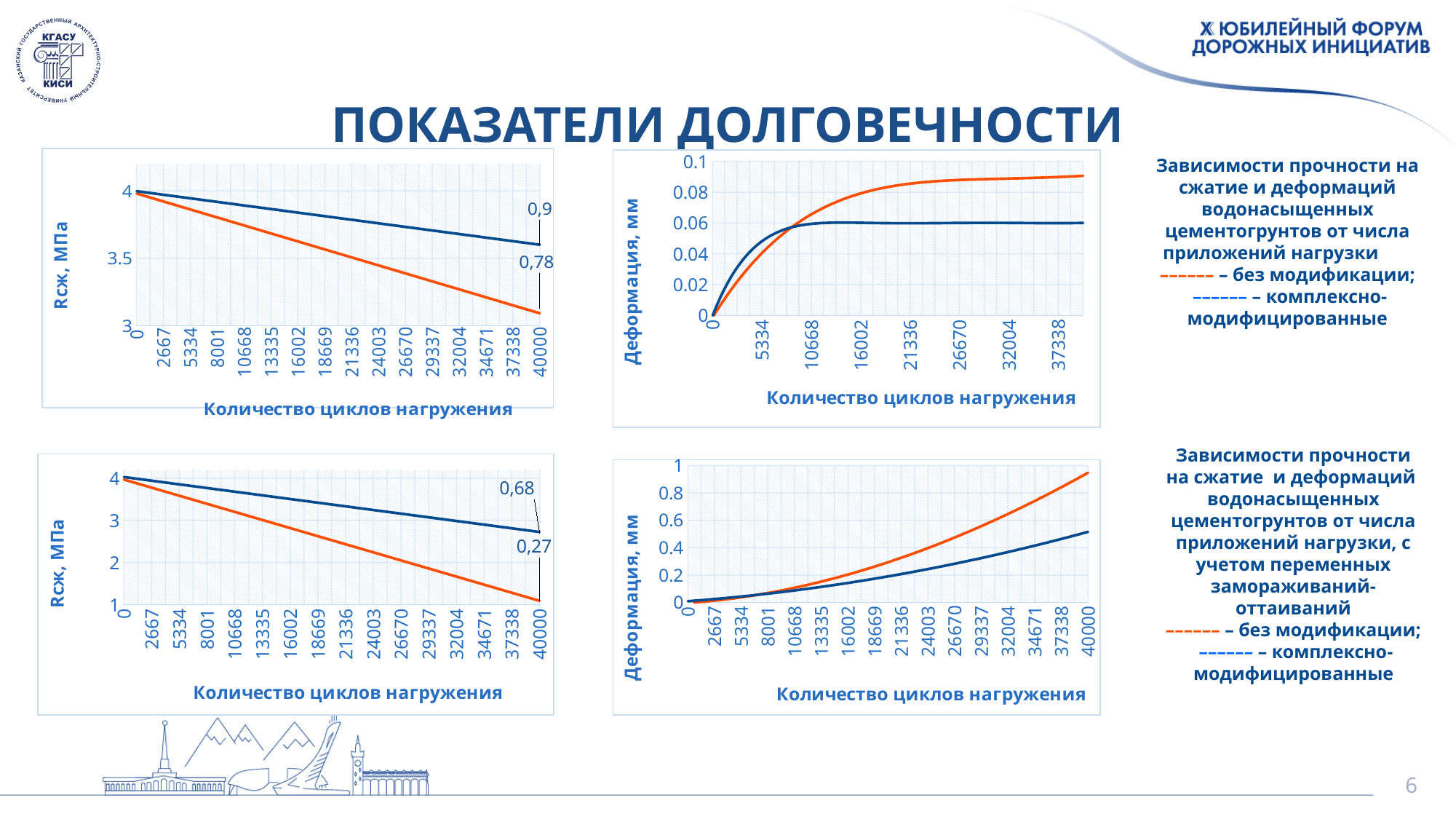
What is the y-axis title of the bottom-right chart? Деформация, мм In the top-left chart, is the value of the blue line at 40000 cycles greater or less than 3.5? greater In the top-right chart, is the value of the orange line at 37338 cycles greater or less than 0.08? greater In the bottom-left chart, is the value of the blue line at 40000 cycles greater or less than 2? greater In the top-left chart, do the values rise or fall as the number of loading cycles increases? fall What kind of chart is the top-left chart on the slide? line chart In the top-right chart, do the values rise or fall as the number of loading cycles increases? rise In the bottom-right chart, which line is higher at 40000 cycles, the orange line or the blue line? the orange line